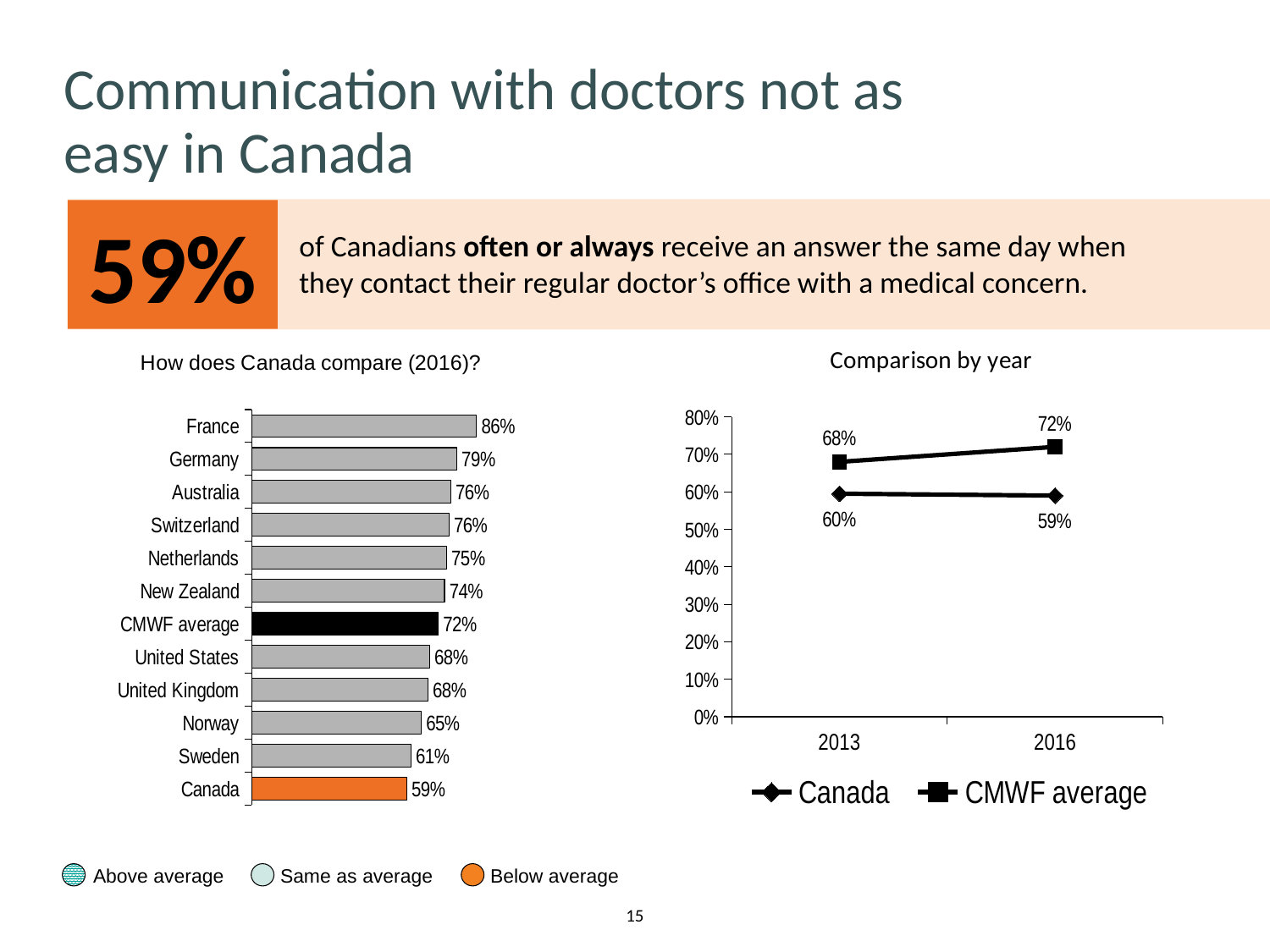
In the 'How does Canada compare (2016)?' chart, what is the value for the CMWF average? 72% In the 'Comparison by year' chart, what is the value for Canada in 2013? 60% In the 'How does Canada compare (2016)?' chart, what is the value for France? 86% In the 'How does Canada compare (2016)?' chart, how many bars are shown? 12 In the 'How does Canada compare (2016)?' chart, which is larger, the value for Norway or the value for Netherlands? Netherlands In the 'Comparison by year' chart, does the CMWF average rise or fall from 2013 to 2016? Rise In the 'How does Canada compare (2016)?' chart, which country has the highest value? France In the 'How does Canada compare (2016)?' chart, what is the difference between Germany and Sweden? 18% In the 'How does Canada compare (2016)?' chart, which country has the lowest value? Canada In the 'Comparison by year' chart, what is the value for the CMWF average in 2016? 72% In the 'Comparison by year' chart, how many series does the legend list? 2 What kind of chart is the 'How does Canada compare (2016)?' chart? Bar chart